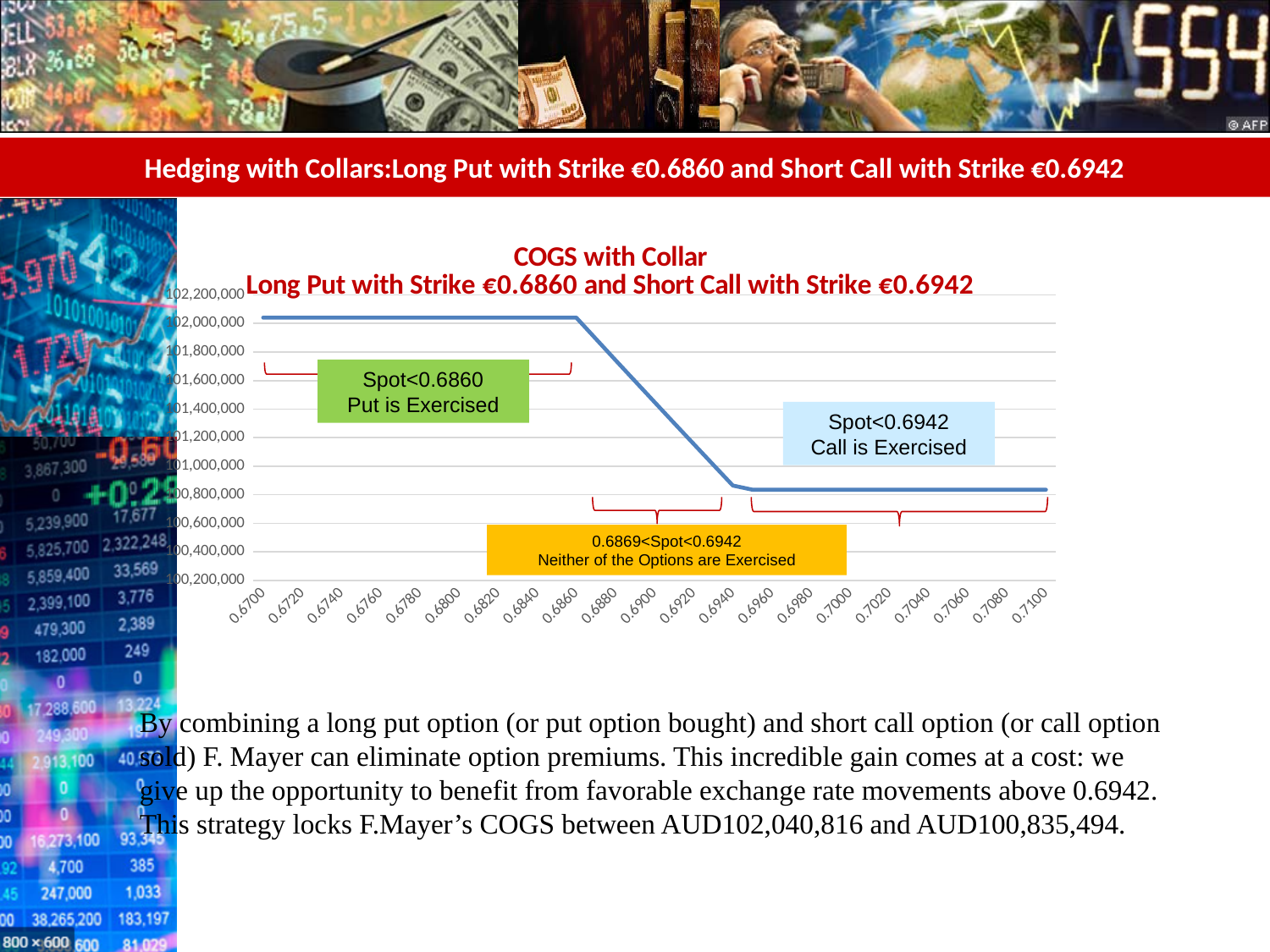
Does the line rise or fall overall as the spot rate increases from 0.6700 to 0.7100? Fall Is the value of the line at a spot rate of 0.7000 greater or less than 101,000,000? less Between which spot rates does the line slope downward? 0.6860 and 0.6942 What kind of chart is shown on the slide? Line chart Is the value of the line at a spot rate of 0.6700 greater or less than 101,800,000? greater Is the value of the line at a spot rate of 0.6900 greater or less than 101,000,000? greater What is the lowest value labelled on the y axis? 100,200,000 How many spot rate tick labels are shown on the x axis? 21 Which spot rate has the higher COGS value on the line, 0.6800 or 0.7000? 0.6800 What is the title of the chart? COGS with Collar Long Put with Strike €0.6860 and Short Call with Strike €0.6942